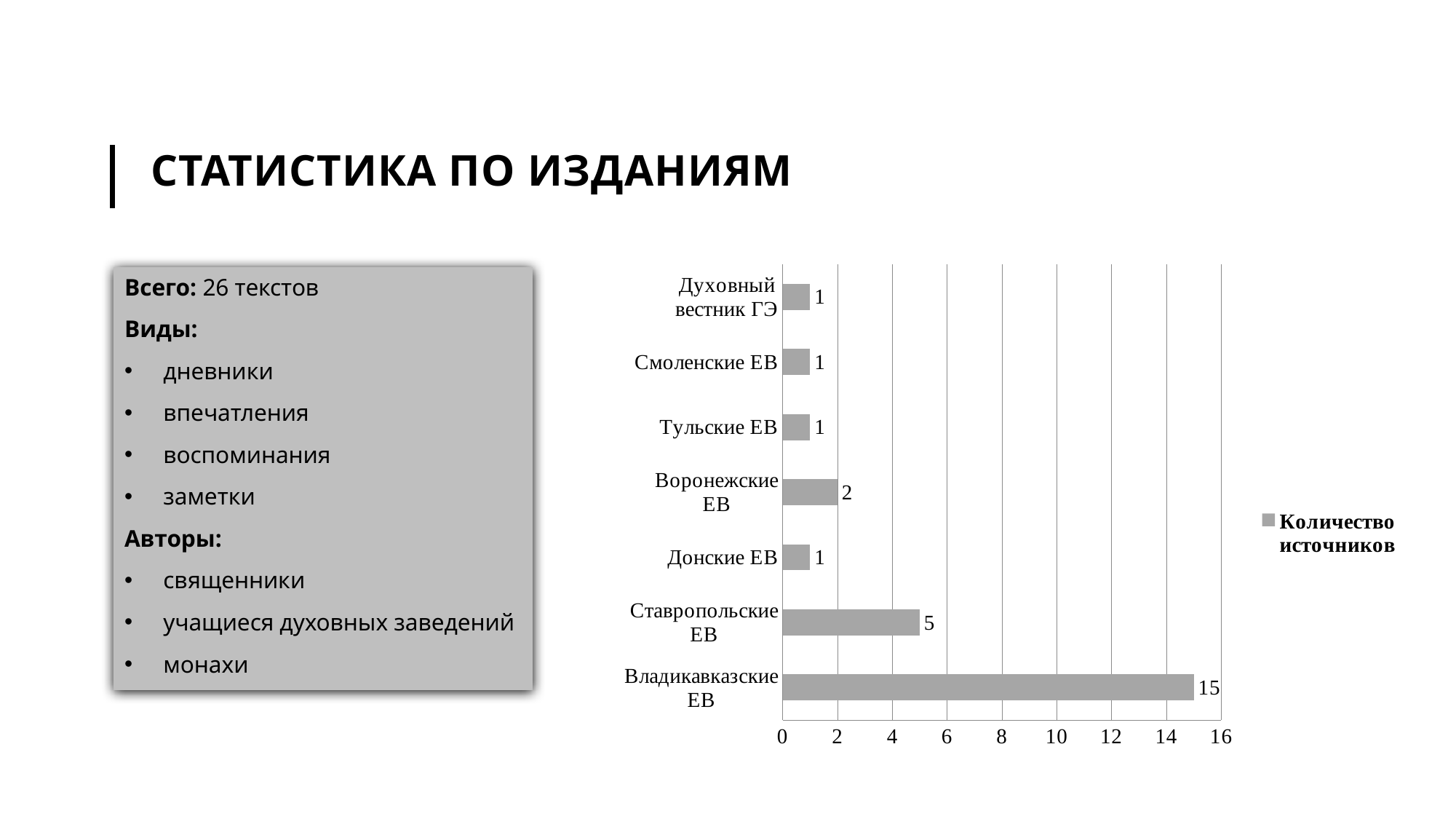
What kind of chart is shown on the slide? bar chart Is the value for Владикавказские ЕВ greater or less than 10? greater Which is larger, the value for Воронежские ЕВ or the value for Донские ЕВ? Воронежские ЕВ What series name does the legend show? Количество источников What is the value for Смоленские ЕВ? 1 What is the difference between the values for Ставропольские ЕВ and Воронежские ЕВ? 3 What is the difference between the values for Владикавказские ЕВ and Ставропольские ЕВ? 10 How many categories are shown in the chart? 7 What is the value for Владикавказские ЕВ? 15 What is the value for Воронежские ЕВ? 2 What is the value for Ставропольские ЕВ? 5 Which category has the highest value? Владикавказские ЕВ